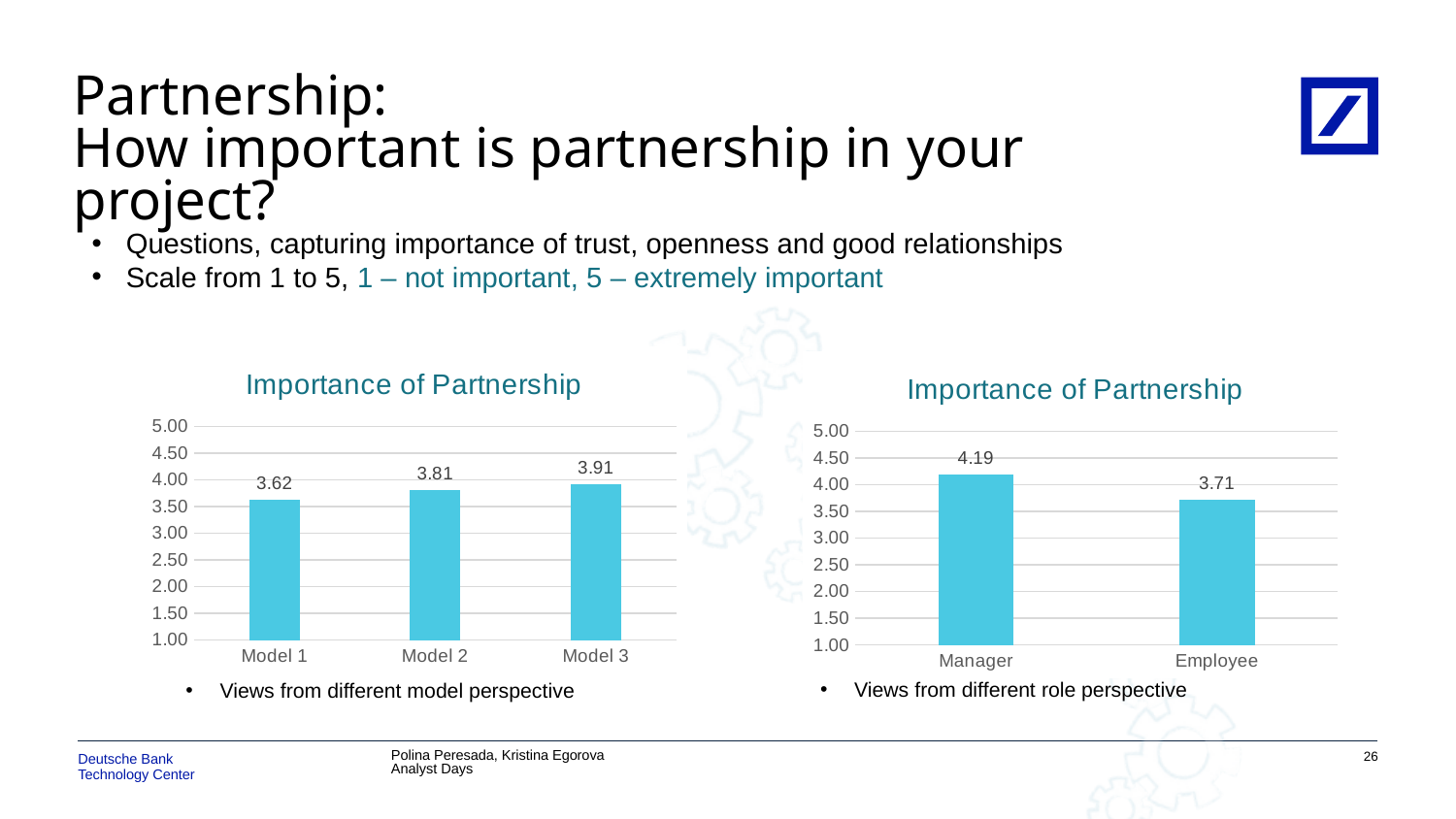
In the left chart (Importance of Partnership by model), what is the value for Model 1? 3.62 In the left chart (Importance of Partnership by model), do the values rise or fall from Model 1 to Model 3? rise In the left chart (Importance of Partnership by model), which model has the lowest value? Model 1 In the left chart (Importance of Partnership by model), how many models are shown? 3 In the right chart (Importance of Partnership by role), what is the difference between the Manager and Employee values? 0.48 In the right chart (Importance of Partnership by role), what is the value for Manager? 4.19 In the right chart (Importance of Partnership by role), what is the value for Employee? 3.71 In the right chart (Importance of Partnership by role), which role has the higher value, Manager or Employee? Manager What type of chart is the right chart (Importance of Partnership by role)? bar chart In the left chart (Importance of Partnership by model), what is the difference between Model 3 and Model 1? 0.29 In the left chart (Importance of Partnership by model), which model has the highest value? Model 3 In the left chart (Importance of Partnership by model), what is the value for Model 3? 3.91